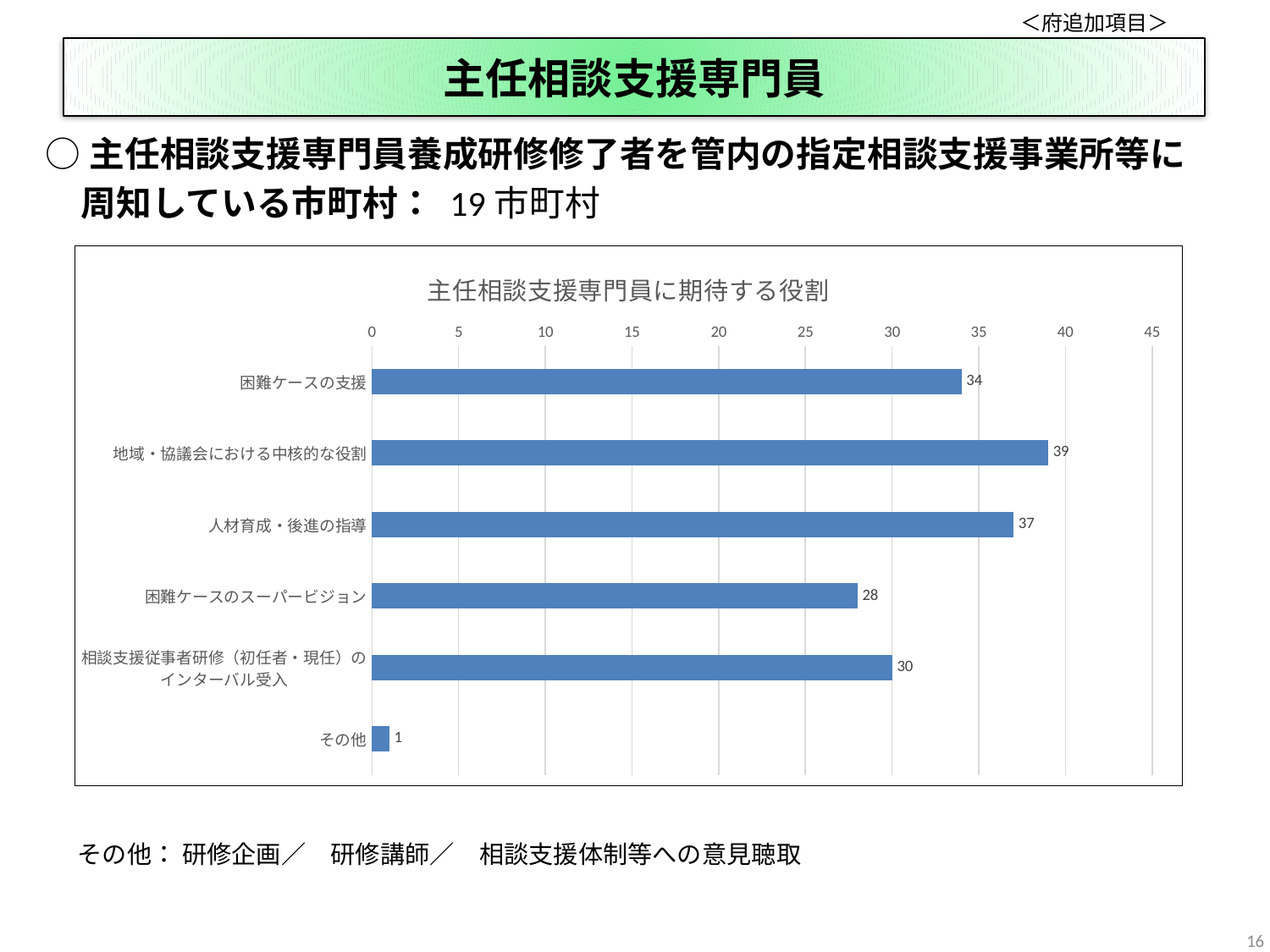
Which is larger, the value for 人材育成・後進の指導 or the value for 相談支援従事者研修（初任者・現任）のインターバル受入? 人材育成・後進の指導 What is the value for 地域・協議会における中核的な役割? 39 What is the value for 困難ケースのスーパービジョン? 28 What is the value for 困難ケースの支援? 34 What is the title of the chart? 主任相談支援専門員に期待する役割 What is the value for その他? 1 Which category has the highest value? 地域・協議会における中核的な役割 What is the value for 人材育成・後進の指導? 37 How many categories are shown in the chart? 6 What is the difference between the values for 地域・協議会における中核的な役割 and 困難ケースのスーパービジョン? 11 What kind of chart is shown on the slide? Bar chart Which category has the lowest value? その他